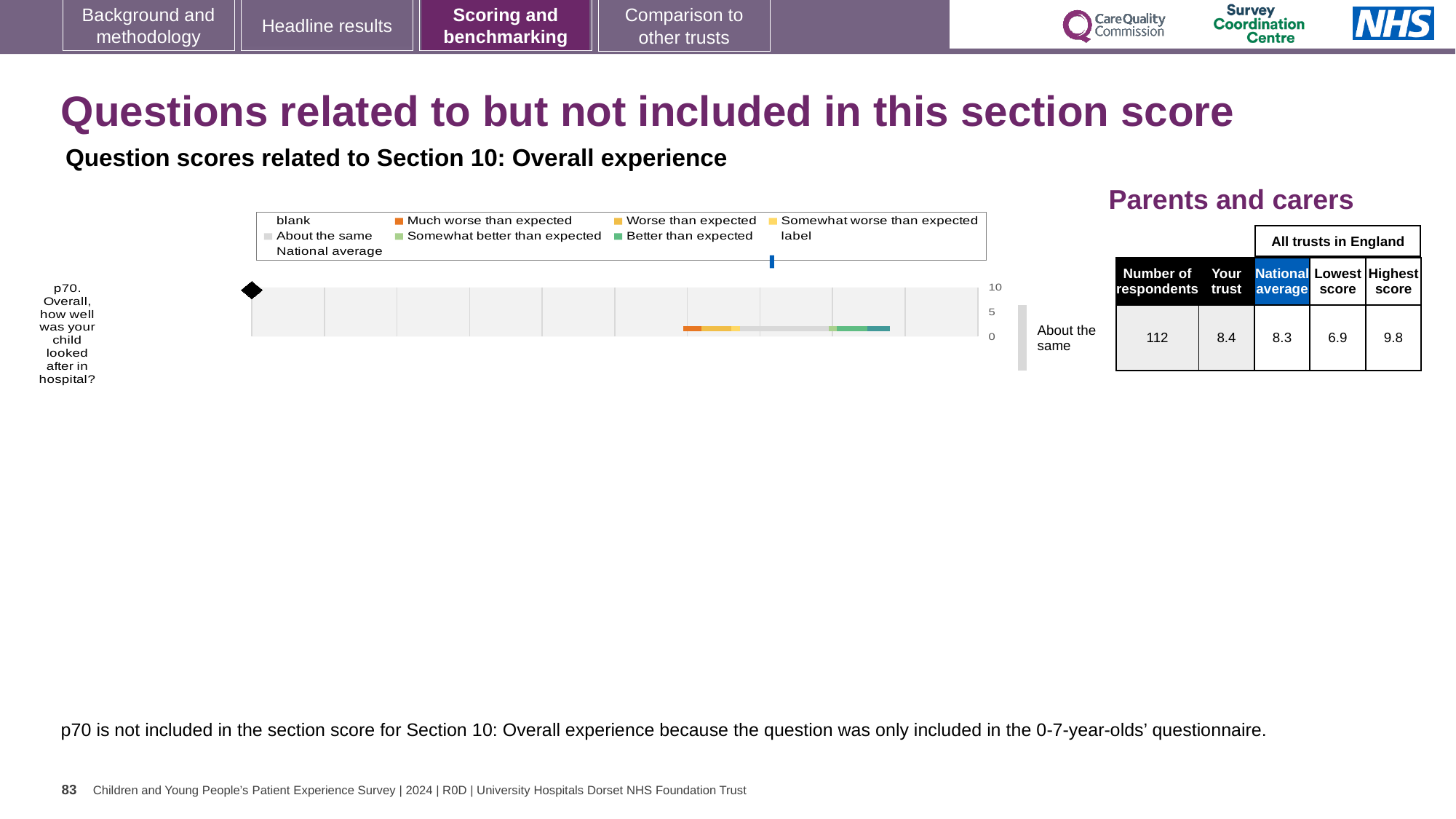
What is the lowest score among all trusts in England for p70? 6.9 How many questions (categories) are plotted in the chart? 1 What is the difference between the highest score and the lowest score for p70? 2.9 What is the national average score for p70 in the Parents and carers table? 8.3 How many respondents answered p70 according to the table? 112 What kind of chart is used to show the p70 question score? bar chart What is the highest score among all trusts in England for p70? 9.8 What is the maximum value shown on the chart's vertical axis? 10 Which is larger for p70: the 'Your trust' score or the national average? Your trust What is the 'Your trust' score for p70 in the Parents and carers table? 8.4 Is the 'Your trust' score for p70 greater or less than 5? greater What benchmark category label is shown next to the p70 bar? About the same